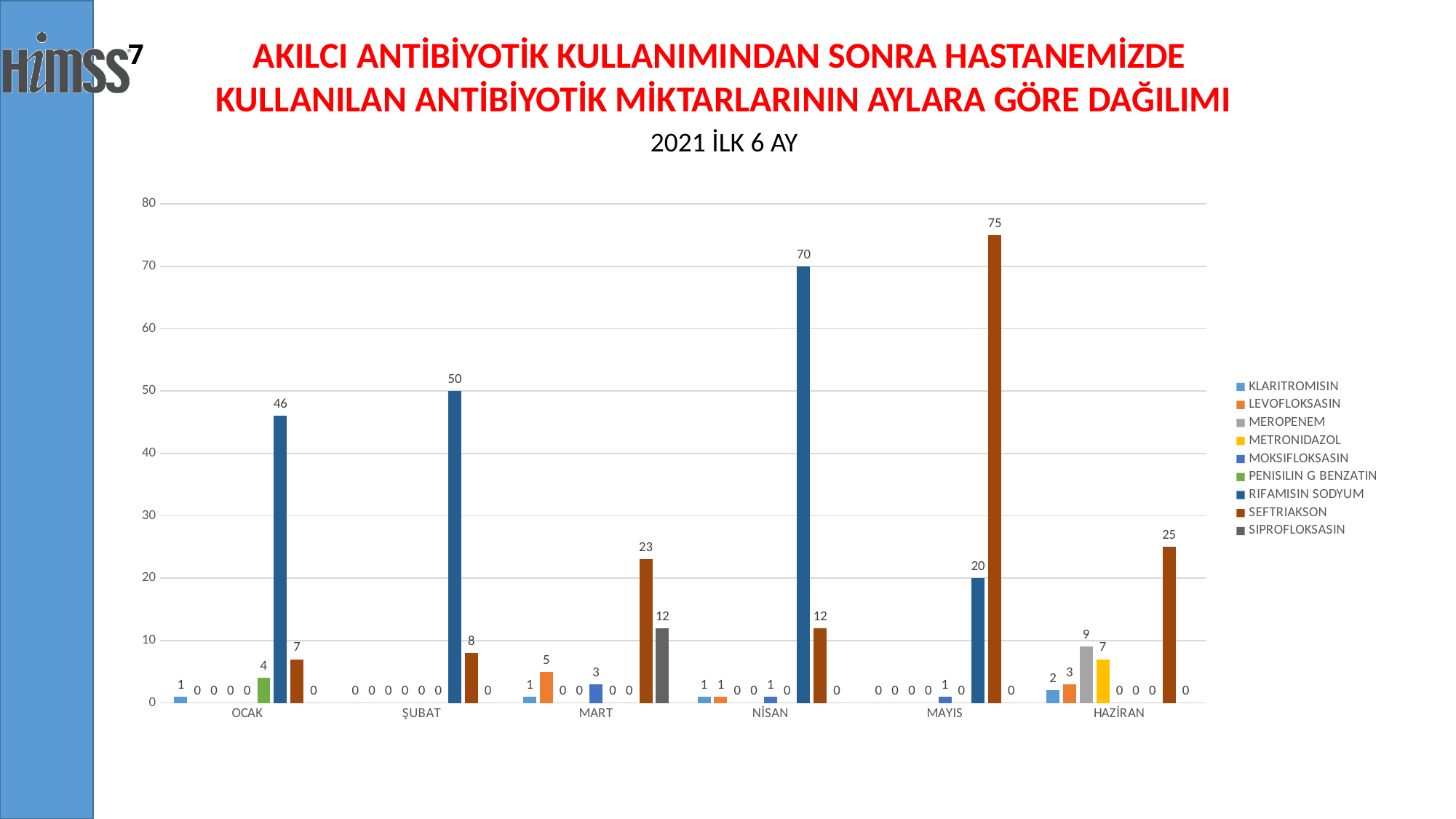
What is the value for SIPROFLOKSASIN in MART? 12 What type of chart is shown on the slide? bar chart How many months are shown on the x axis? 6 How many series does the legend list? 9 What is the value for MEROPENEM in HAZİRAN? 9 What is the value for SEFTRIAKSON in MAYIS? 75 What is the value for RIFAMISIN SODYUM in NİSAN? 70 Which is larger in MART: the SEFTRIAKSON value or the SIPROFLOKSASIN value? SEFTRIAKSON In which month is the SEFTRIAKSON value highest? MAYIS In which month is the RIFAMISIN SODYUM value highest? NİSAN What is the difference between the RIFAMISIN SODYUM values in ŞUBAT and OCAK? 4